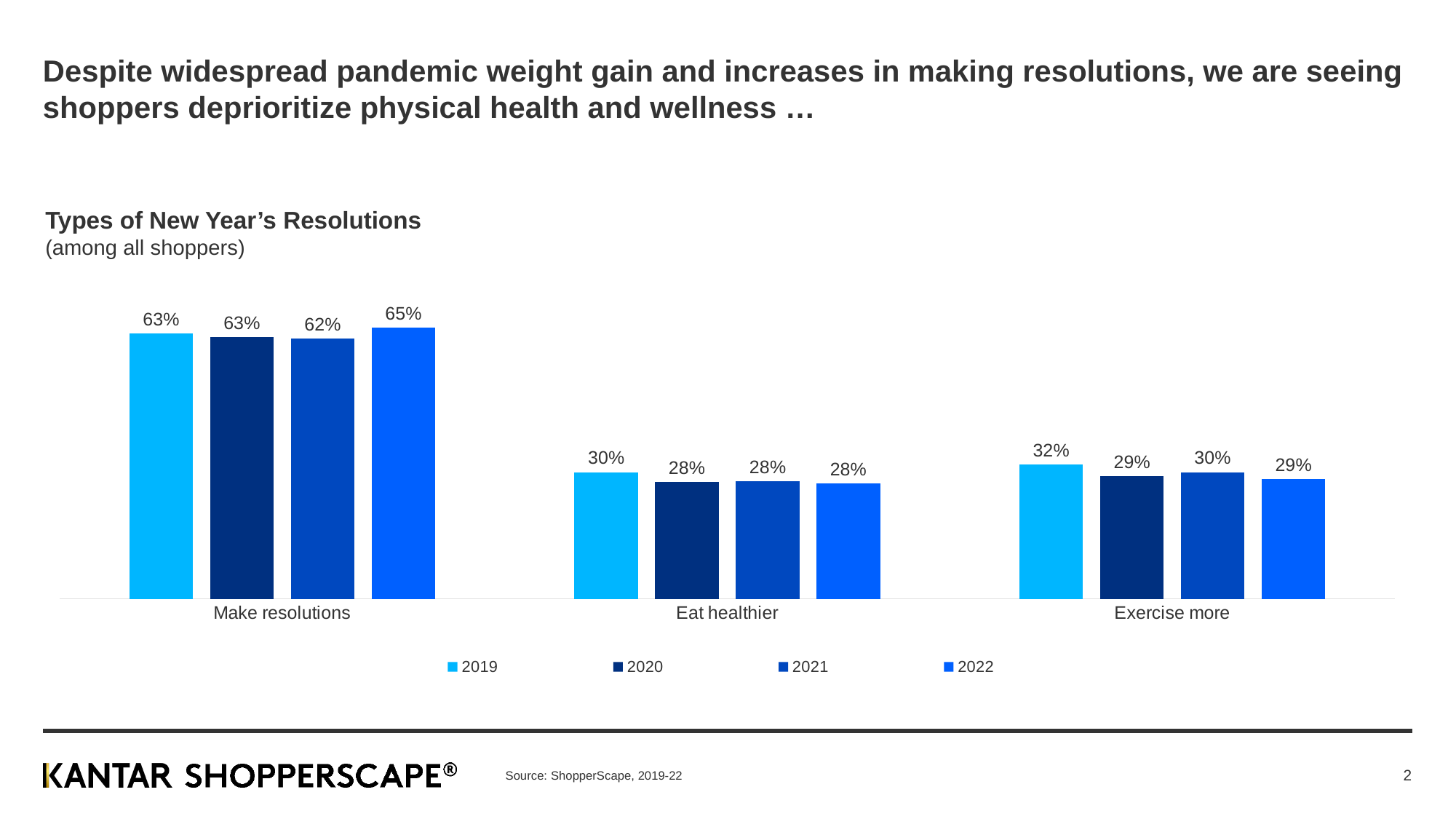
How many series does the legend list? 4 What kind of chart is shown on the slide? Bar chart Which is larger: the 2019 value for Eat healthier or the 2019 value for Exercise more? Exercise more What is the title of the chart? Types of New Year's Resolutions Which year has the lowest value for Make resolutions? 2021 What percentage of shoppers said they make resolutions in 2022? 65% Which category has the highest values across all years? Make resolutions What is the value for Exercise more in 2021? 30% What is the value for Eat healthier in 2019? 30% How many categories are shown on the x axis? 3 What is the difference between the 2022 and 2021 values for Make resolutions? 3% What is the difference between the 2019 and 2022 values for Exercise more? 3%